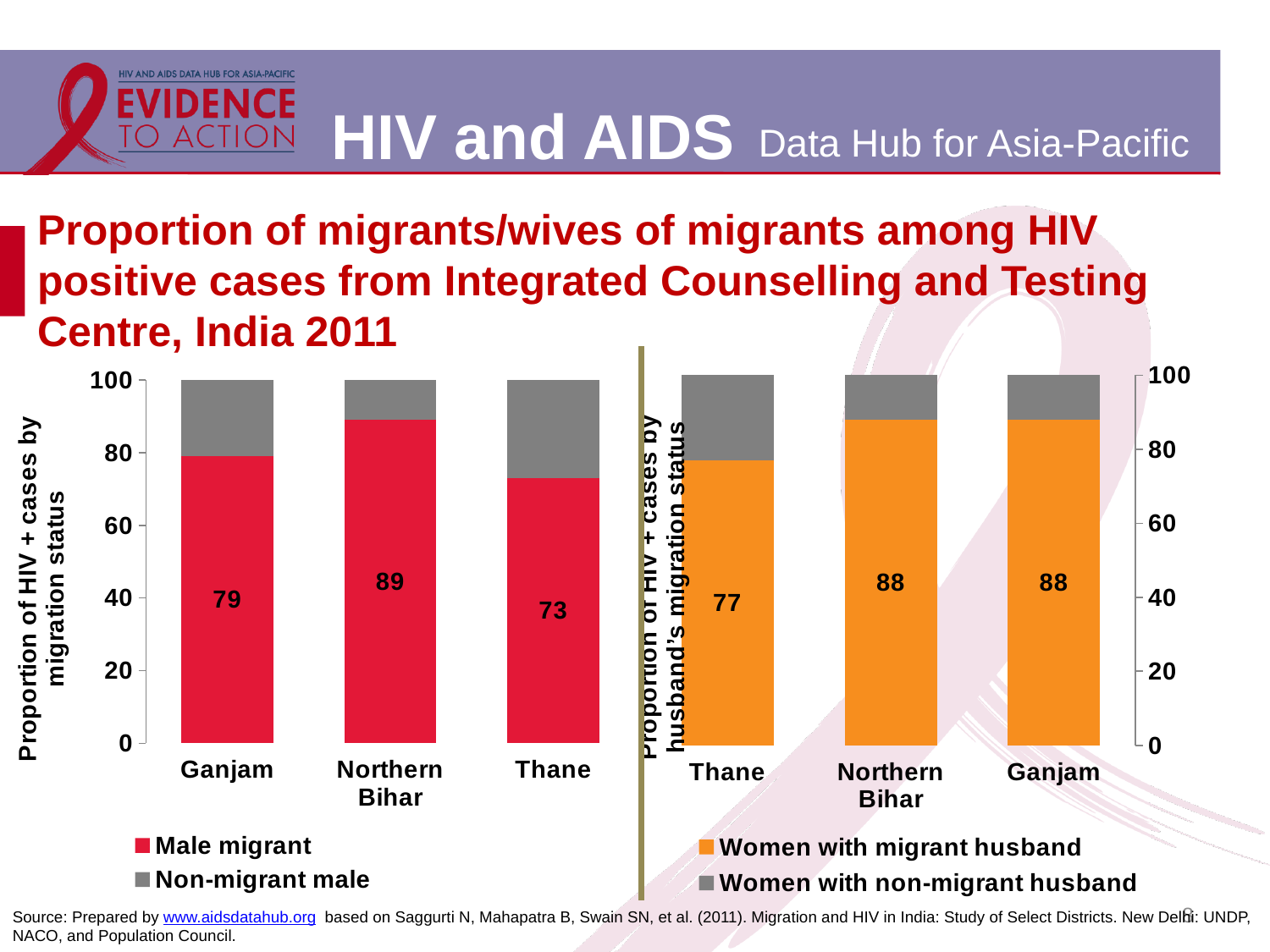
In the right chart (women), what is the value for Women with migrant husband in Thane? 77 How many series does the legend of the right chart (women) list? 2 In the left chart (male migrants), what is the difference between the Male migrant values for Northern Bihar and Thane? 16 In the left chart (male migrants), which district has the lowest Male migrant value? Thane In the left chart (male migrants), what is the value for Male migrant in Northern Bihar? 89 In the right chart (women), what is the difference between the Women with migrant husband values for Ganjam and Thane? 11 In the left chart (male migrants), which district has the highest Male migrant value? Northern Bihar In the left chart (male migrants), what is the value for Male migrant in Thane? 73 In the right chart (women), which district has the lowest value for Women with migrant husband? Thane In the left chart (male migrants), what is the value for Male migrant in Ganjam? 79 Is the Male migrant value for Ganjam in the left chart greater or less than the Women with migrant husband value for Ganjam in the right chart? less In the right chart (women), what is the value for Women with migrant husband in Northern Bihar? 88